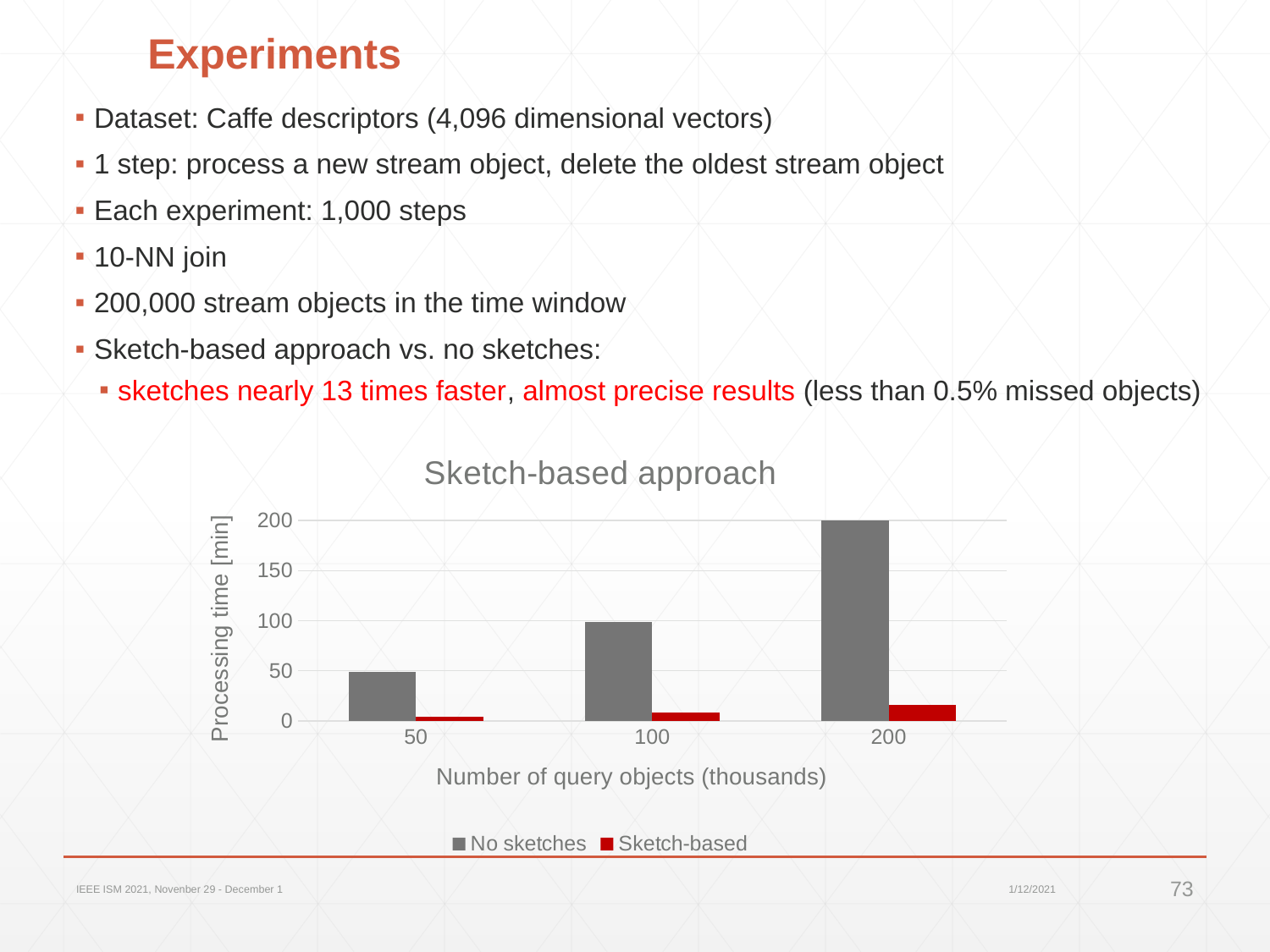
Is the Sketch-based value at 200 thousand query objects greater or less than 50? less For which number of query objects is the No sketches processing time lowest? 50 At 100 thousand query objects, which series has the larger processing time, No sketches or Sketch-based? No sketches Does the No sketches processing time rise or fall as the number of query objects increases? rise How many series does the chart legend list? 2 Is the No sketches value at 100 thousand query objects greater or less than 150? less What is the label of the y axis of the chart? Processing time [min] What kind of chart is shown on the slide? bar chart Is the No sketches value at 200 thousand query objects greater or less than 150? greater For which number of query objects is the No sketches processing time highest? 200 What is the title of the chart? Sketch-based approach How many categories are shown on the x axis of the chart? 3